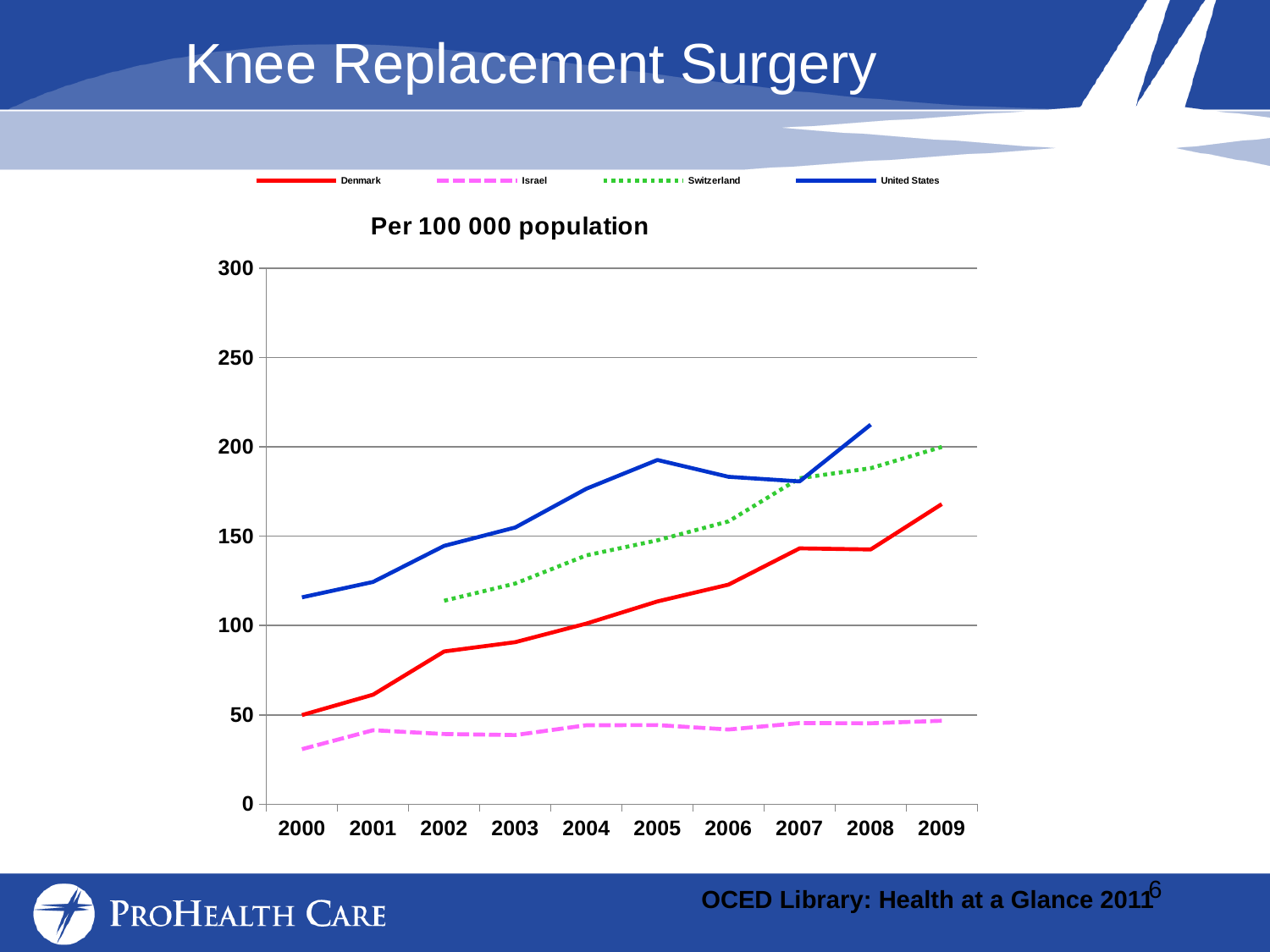
Is the value for the United States in 2008 greater or less than 200? greater Which country has the highest value in 2005? United States How many series does the legend list? 4 How many years are shown along the x axis? 10 Is the value for Denmark in 2002 greater or less than 100? less What kind of chart is shown on the slide? line chart Does the value for Denmark rise or fall from 2000 to 2009? rise Is the value for Israel in 2000 greater or less than 50? less Which country has the lowest value in 2009? Israel Which is larger in 2009, the value for Switzerland or the value for Denmark? Switzerland What unit is stated in the chart's title? Per 100 000 population